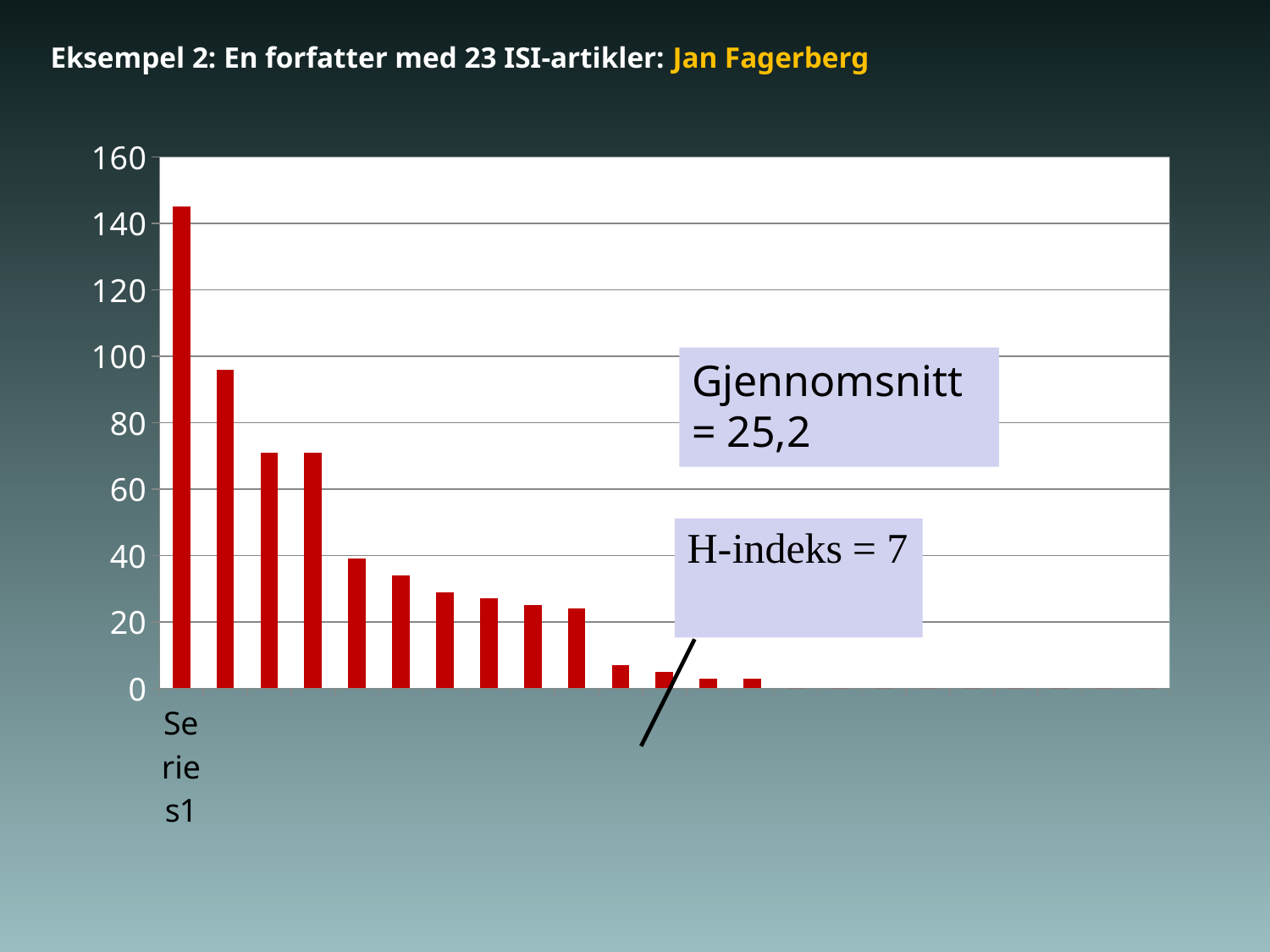
What average (Gjennomsnitt) value is stated in the text box on the chart? 25,2 Is the value of the second bar from the left greater or less than 80? greater What H-index (H-indeks) value is stated on the chart? 7 Which is larger, the leftmost bar or the second bar from the left? the leftmost bar Do the bar values rise or fall from left to right along the x axis? fall What is the highest value shown on the y axis? 160 Which bar has the highest value in the chart? the leftmost (first) bar Is the value of the second bar from the left greater or less than 100? less Is the value of the fifth bar from the left greater or less than 60? less What kind of chart is shown on the slide? bar chart